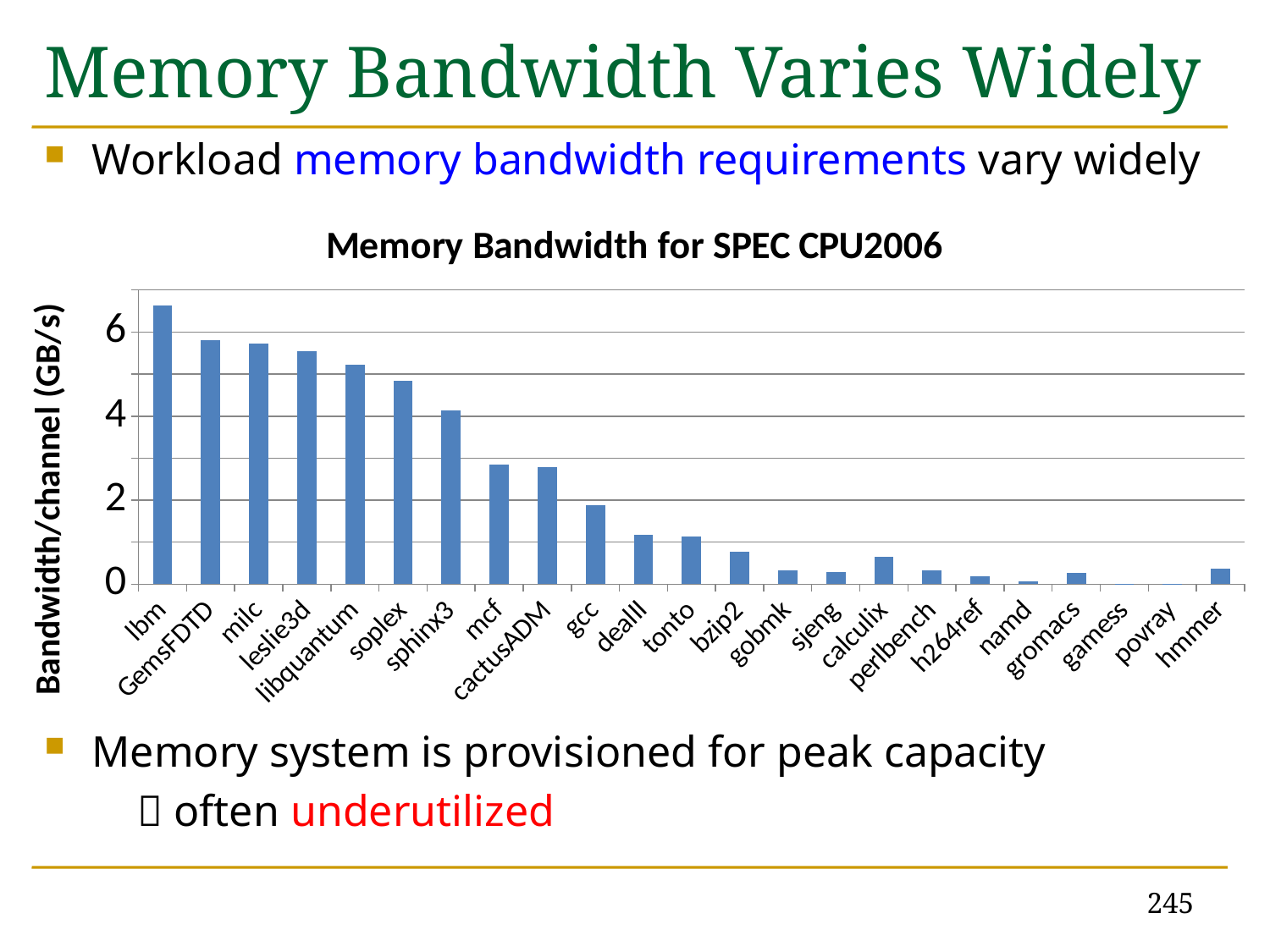
Is the value for gcc greater or less than 2? less Is the value for bzip2 greater or less than 2? less What is the label of the vertical axis? Bandwidth/channel (GB/s) How many benchmarks are plotted on the x axis? 23 Is the value for lbm greater or less than 6? greater What is the title of the chart? Memory Bandwidth for SPEC CPU2006 Which benchmark has the highest memory bandwidth? lbm What kind of chart is shown on the slide? bar chart Which has a higher memory bandwidth, lbm or gcc? lbm Do the bar values generally rise or fall from left to right along the x axis? fall